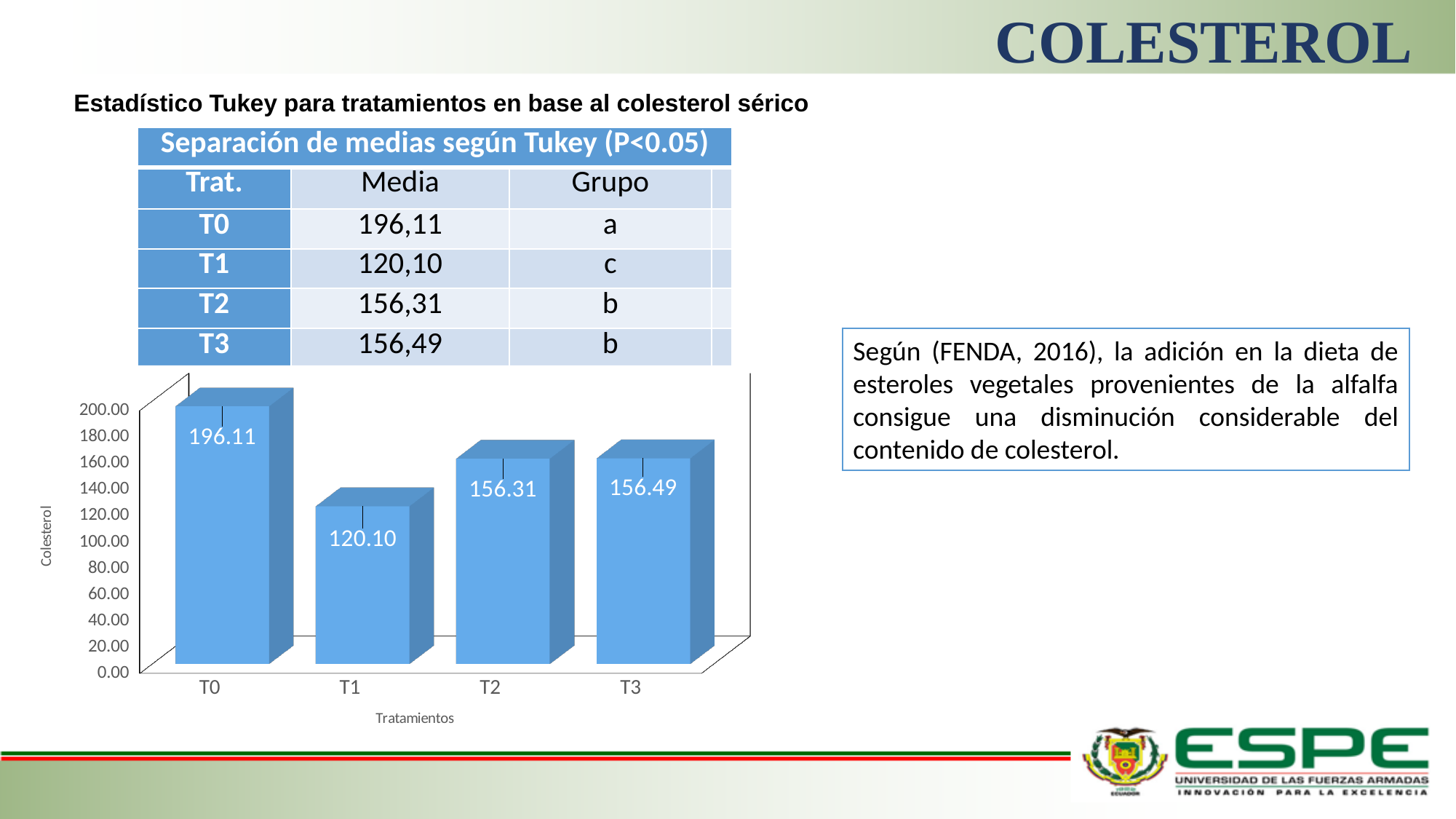
Is the value for T1 in the bar chart greater or less than 140.00? less Which is larger in the bar chart, the value for T1 or the value for T3? T3 What is the value for T2 in the bar chart? 156.31 Which treatment has the highest value in the bar chart? T0 How many treatments are shown on the x axis of the bar chart? 4 What is the value for T3 in the bar chart? 156.49 What kind of chart is shown on the slide? bar chart What is the value for T0 in the bar chart? 196.11 What is the value for T1 in the bar chart? 120.10 What is the difference between the values for T0 and T2 in the bar chart? 39.80 Which treatment has the lowest value in the bar chart? T1 What is the difference between the values for T0 and T1 in the bar chart? 76.01